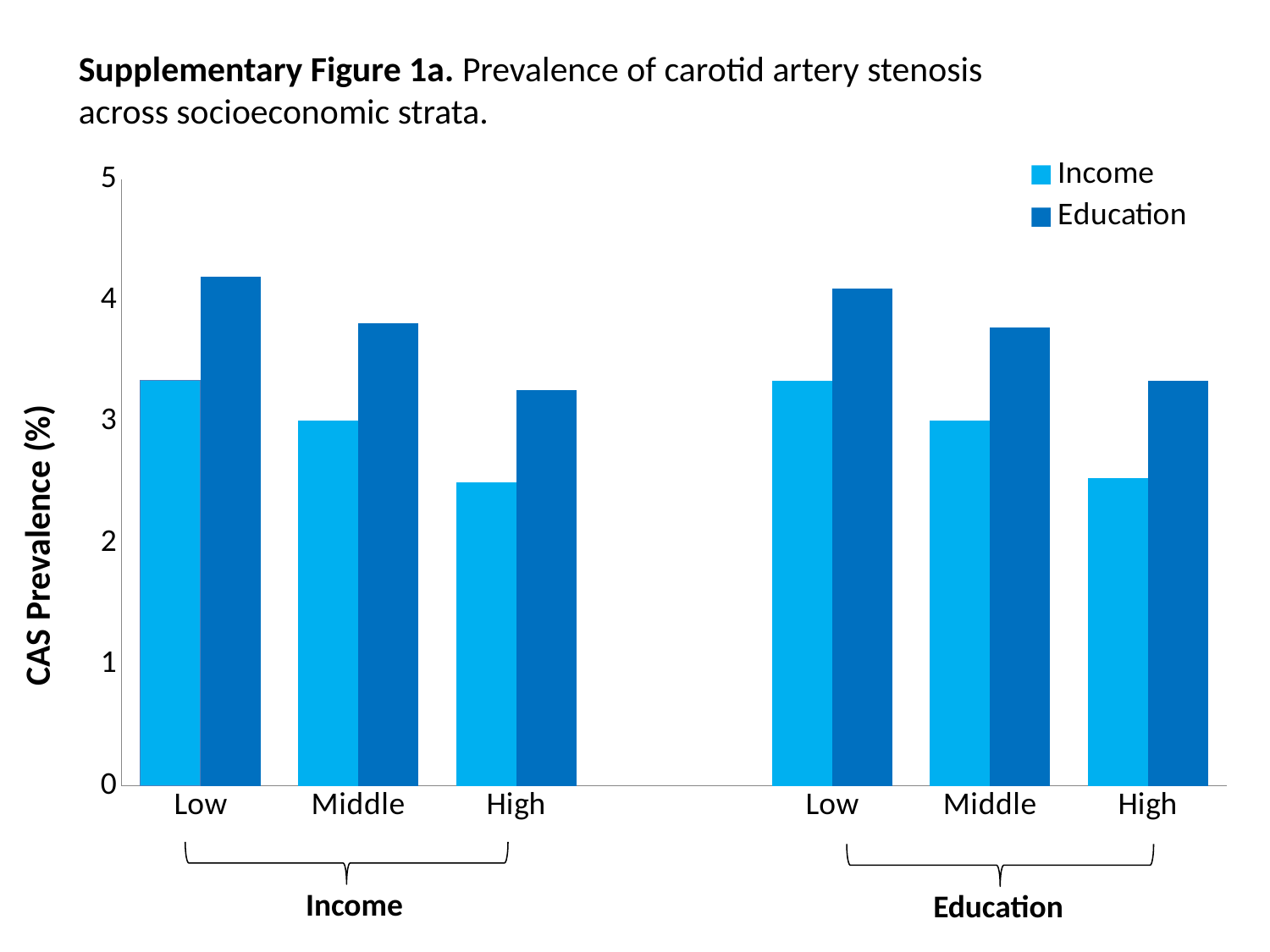
In the Income group, which category has the highest Education series bar? Low In the Income group, for the High category, which series has the larger value, Income or Education? Education How many category labels are shown along the x axis? 6 What is the label of the y axis? CAS Prevalence (%) In the Education group, which category has the lowest Income series bar? High In the Education group, is the Education series value for High greater or less than 3? greater In the Income group, is the Education series value for Low greater or less than 4? greater In the Income group, is the Income series value for High greater or less than 3? less How many series does the legend list? 2 In the Income group, does the Income series rise or fall from Low to High? fall What kind of chart is shown on the slide? bar chart